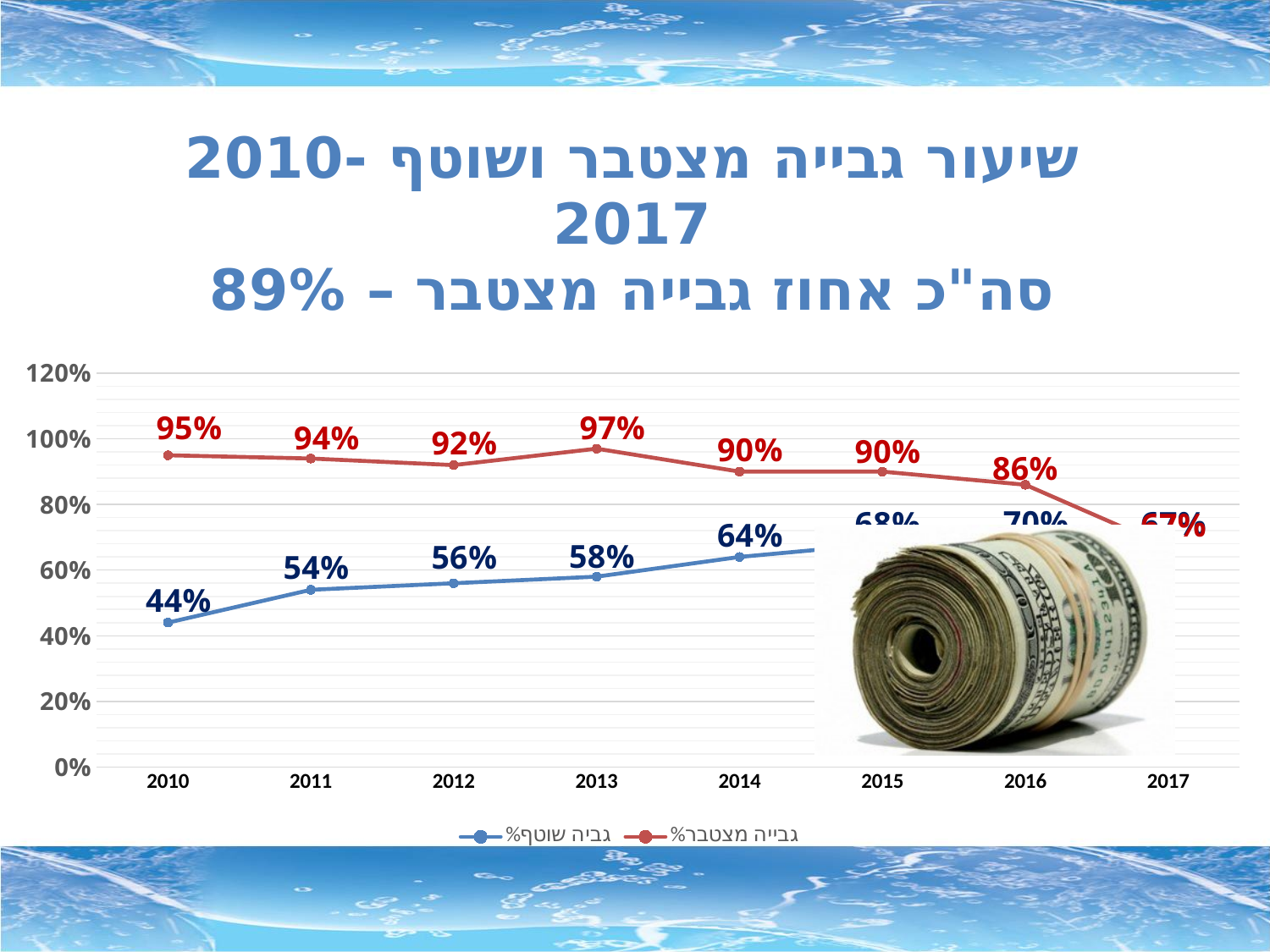
What kind of chart is shown on the slide? Line chart What is the difference between the red series value in 2010 and in 2016? 9 percentage points Is the value of the red series in 2014 greater or less than 80%? greater In which year is the red series (גבייה מצטבר%) at its lowest? 2017 What is the value of the blue series (גבייה שוטף%) in 2014? 64% In 2012, which series has the higher value, the red (גבייה מצטבר%) or the blue (גבייה שוטף%)? Red (גבייה מצטבר%) What is the value of the red series (גבייה מצטבר%) in 2013? 97% How many series does the legend list? 2 What is the value of the blue series (גבייה שוטף%) in 2010? 44% In which year does the red series (גבייה מצטבר%) reach its highest value? 2013 What is the value of the red series (גבייה מצטבר%) in 2010? 95% How many years are shown on the x axis? 8